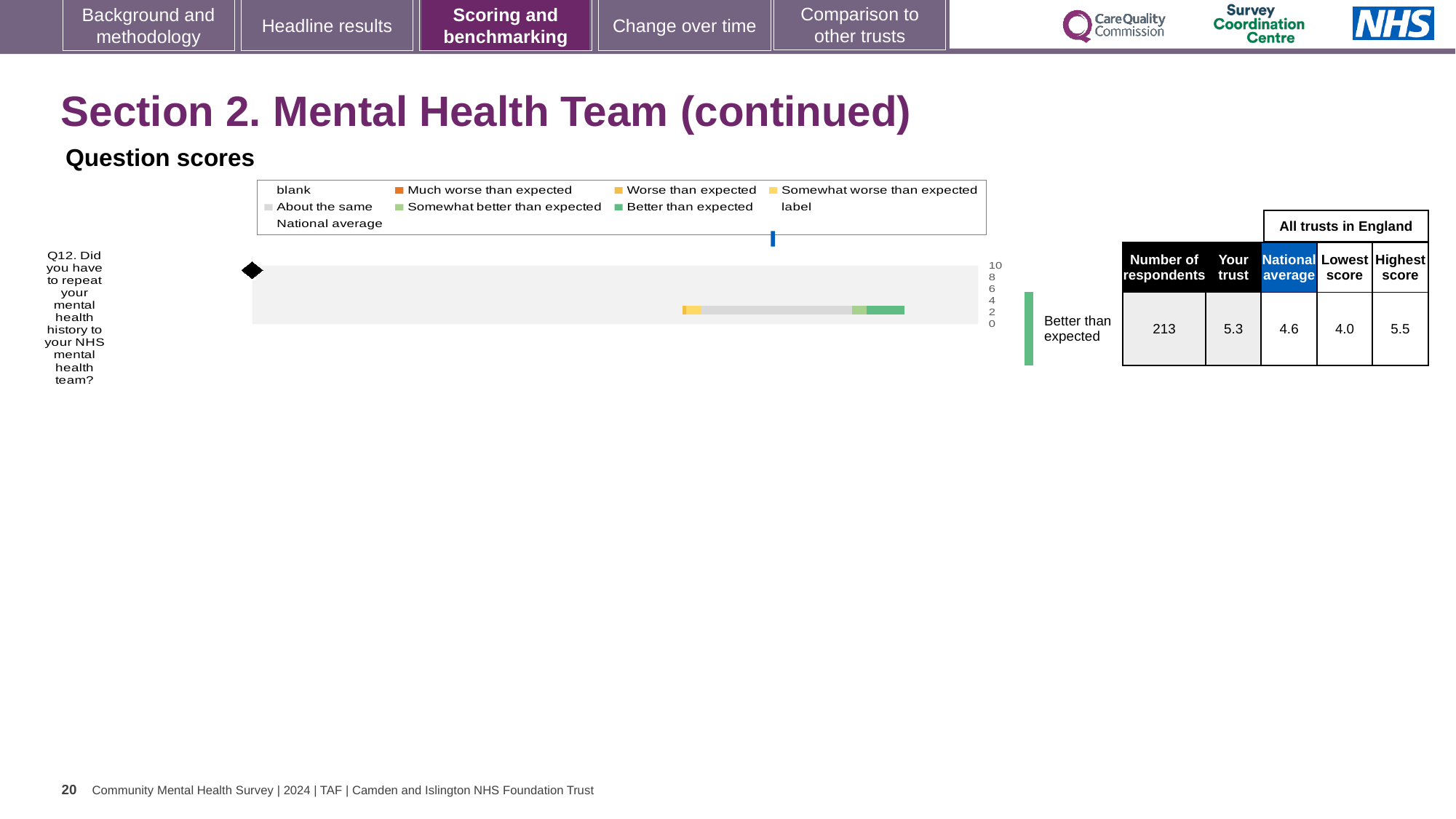
What kind of chart is used to show the Q12 question score? bar chart Which is larger for Q12, the 'Your trust' score or the national average? Your trust What rating label is shown next to the Q12 bar? Better than expected What is the difference between the highest and lowest scores among all trusts in England for Q12? 1.5 What is the 'Your trust' score for Q12? 5.3 Which question is plotted in the chart? Q12. Did you have to repeat your mental health history to your NHS mental health team? How many respondents answered Q12? 213 What is the highest score among all trusts in England for Q12? 5.5 How many survey questions are plotted in the chart? 1 What is the lowest score among all trusts in England for Q12? 4.0 What is the national average score for Q12? 4.6 What is the difference between the 'Your trust' score and the national average for Q12? 0.7